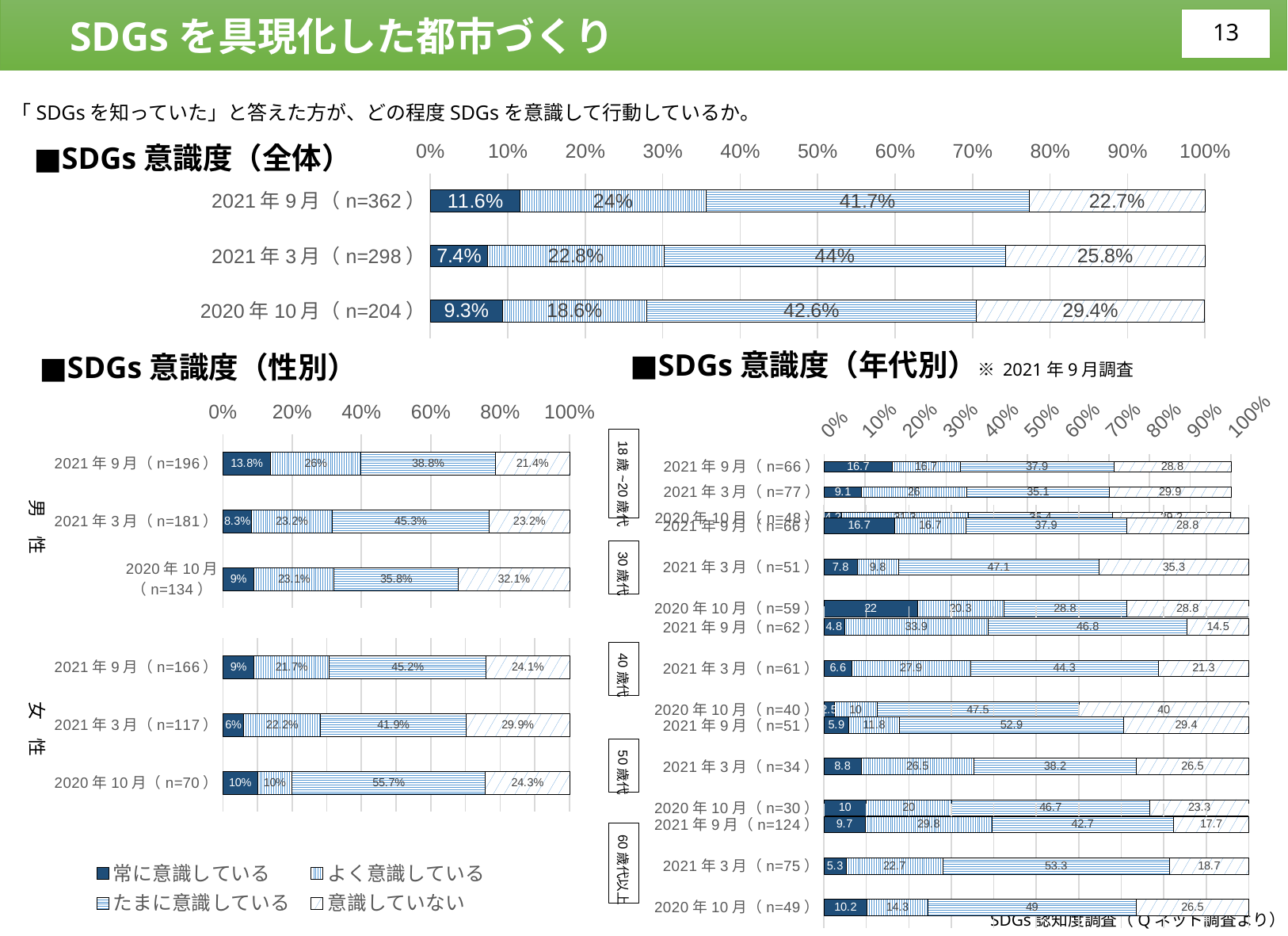
In the SDGs意識度（年代別） chart, what is the たまに意識している value for 60歳代以上 in 2021年3月 (n=75)? 53.3 In the SDGs意識度（全体） chart, what is the value for 意識していない in 2020年10月 (n=204)? 29.4% What kind of chart is the SDGs意識度（全体） chart? Stacked bar chart In the SDGs意識度（全体） chart, what is the value for 常に意識している in 2021年9月 (n=362)? 11.6% In the SDGs意識度（性別） chart, what is the たまに意識している value for 女性 in 2020年10月 (n=70)? 55.7% In the SDGs意識度（全体） chart, what is the difference between the たまに意識している values for 2021年3月 and 2021年9月? 2.3% In the SDGs意識度（性別） chart, how many bars are plotted in total? 6 In the SDGs意識度（年代別） chart, what is the 意識していない value for 30歳代 in 2021年3月 (n=51)? 35.3 How many series does the legend list for the SDGs意識度 charts? 4 In the SDGs意識度（全体） chart, is the 意識していない value larger in 2021年3月 or in 2020年10月? 2020年10月 In the SDGs意識度（性別） chart, what is the 常に意識している value for 男性 in 2021年9月 (n=196)? 13.8% In the SDGs意識度（全体） chart, which survey period has the highest value for 常に意識している? 2021年9月 (n=362)